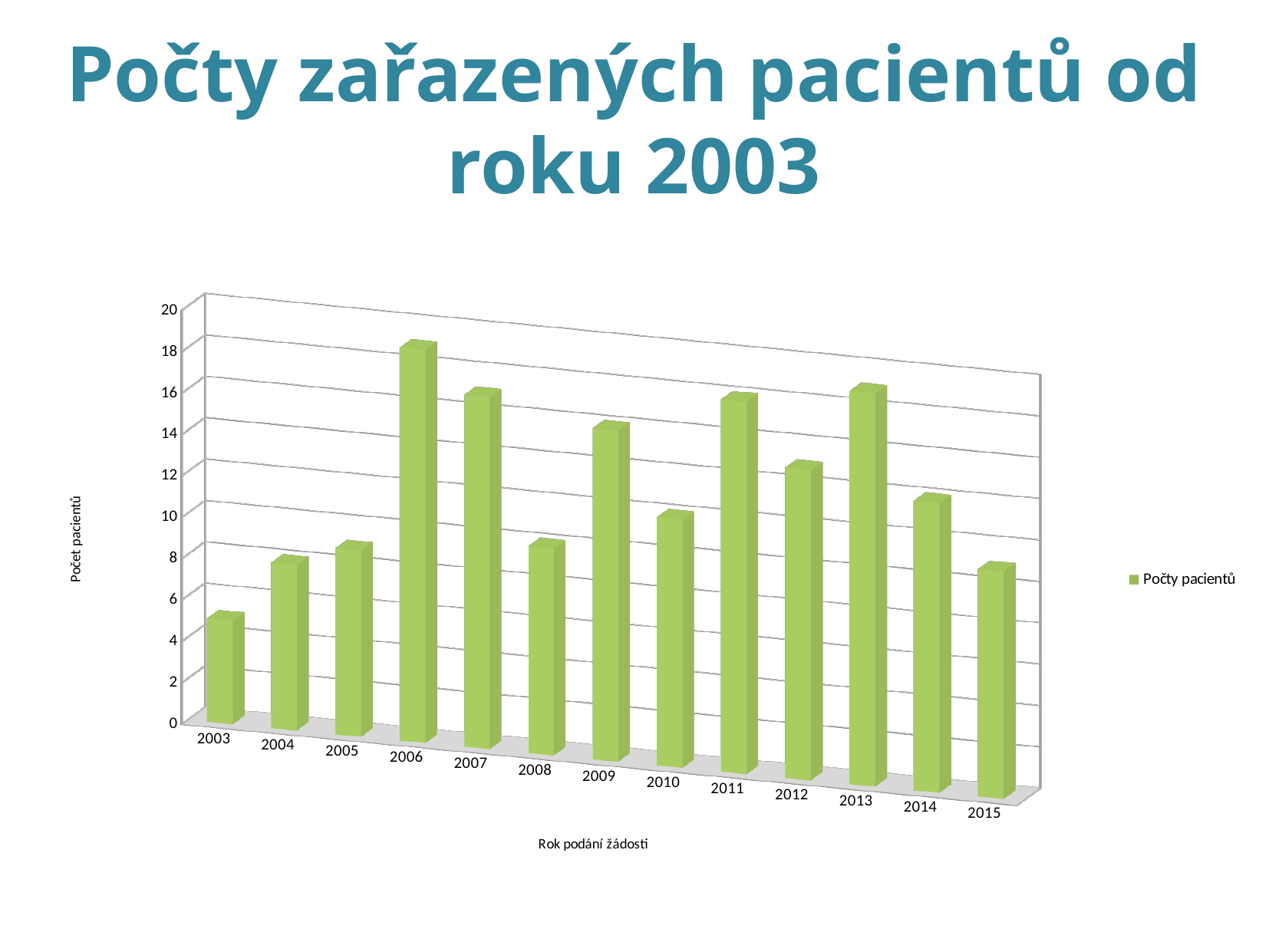
Which year has the larger value, 2006 or 2007? 2006 Which year has the larger value, 2011 or 2012? 2011 What is the label of the x axis? Rok podání žádosti How many series does the legend list? 1 What kind of chart is shown on the slide? bar chart Which year has the lowest number of patients? 2003 Which year has the highest number of patients? 2006 and 2013 (tied) How many years (categories) are plotted on the x axis? 13 Is the value for 2006 greater or less than 16? greater Is the value for 2003 greater or less than 6? less Is the value for 2009 greater or less than 12? greater